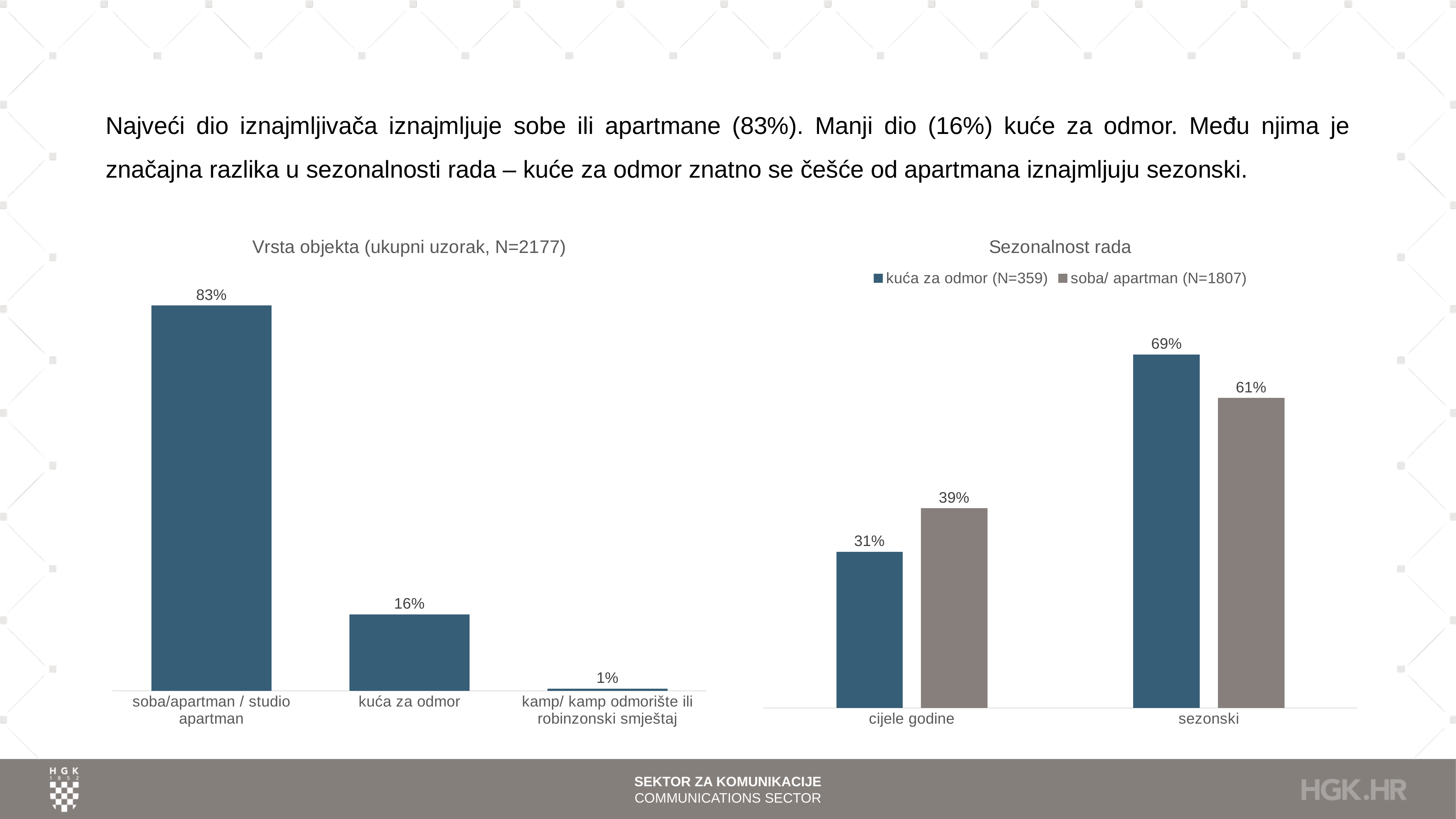
In the 'Vrsta objekta (ukupni uzorak, N=2177)' chart, what is the difference between 'soba/apartman / studio apartman' and 'kuća za odmor'? 67% In the 'Sezonalnost rada' chart, what is the difference between 'kuća za odmor (N=359)' and 'soba/ apartman (N=1807)' in 'sezonski'? 8% In the 'Vrsta objekta (ukupni uzorak, N=2177)' chart, which category has the highest value? soba/apartman / studio apartman What is the title of the chart on the left of the slide? Vrsta objekta (ukupni uzorak, N=2177) In the 'Vrsta objekta (ukupni uzorak, N=2177)' chart, what is the value for 'kuća za odmor'? 16% In the 'Vrsta objekta (ukupni uzorak, N=2177)' chart, which category has the lowest value? kamp/ kamp odmorište ili robinzonski smještaj In the 'Sezonalnost rada' chart, how many series does the legend list? 2 In the 'Sezonalnost rada' chart, what is the value for 'soba/ apartman (N=1807)' in 'cijele godine'? 39% In the 'Vrsta objekta (ukupni uzorak, N=2177)' chart, how many categories are shown? 3 What kind of chart is the 'Sezonalnost rada' chart? bar chart In the 'Sezonalnost rada' chart, which is larger for 'cijele godine': 'kuća za odmor (N=359)' or 'soba/ apartman (N=1807)'? soba/ apartman (N=1807) In the 'Sezonalnost rada' chart, what is the value for 'kuća za odmor (N=359)' in 'sezonski'? 69%